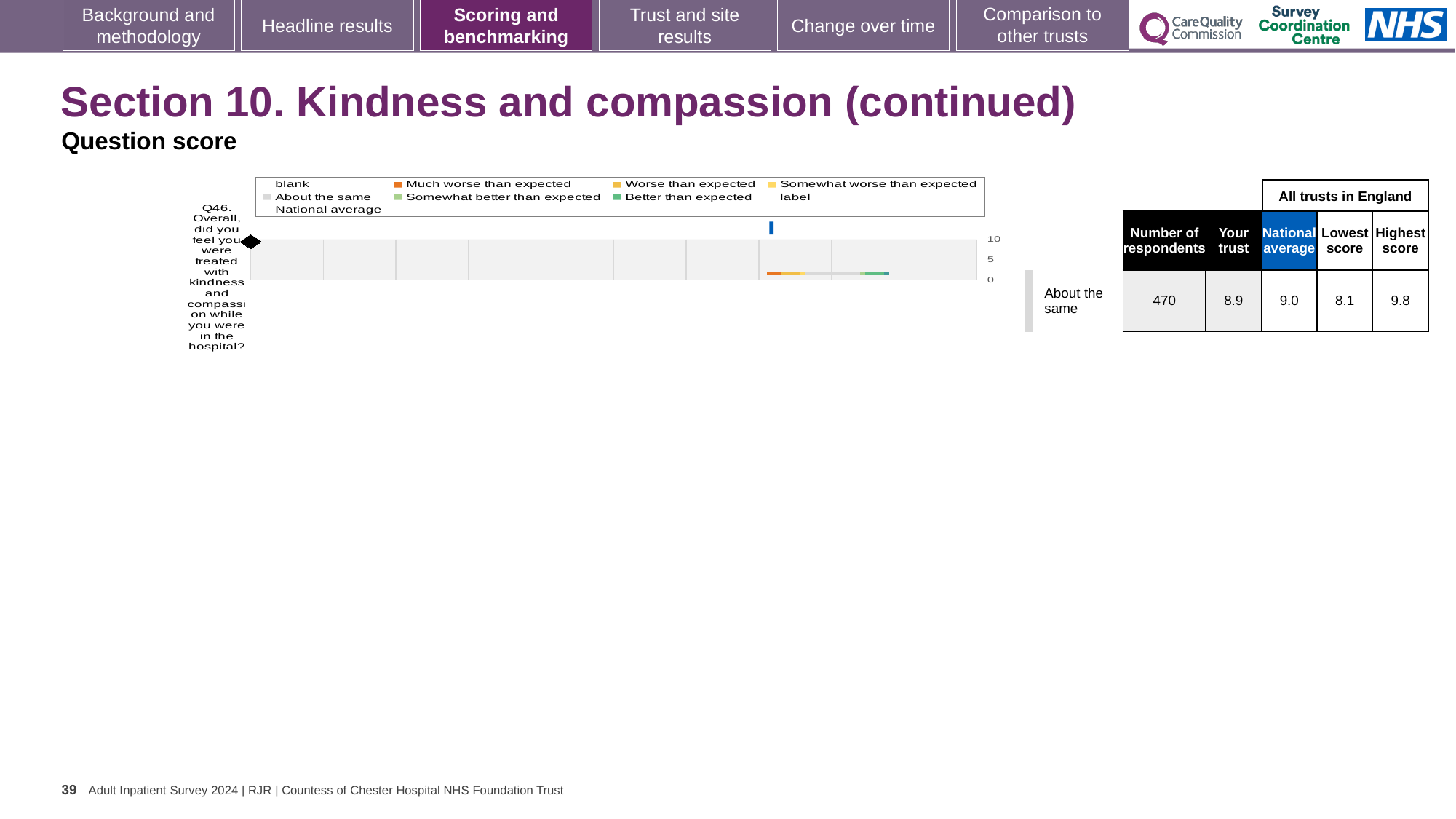
Which benchmark category is the trust's Q46 result placed in? About the same What is the national average score for Q46? 9.0 What colour does the legend use for 'Much worse than expected'? Orange What kind of chart is shown on the slide? Bar chart How many entries does the chart's legend list? 9 Which is larger for Q46, the 'Your trust' score or the national average? National average Which question number does the chart on the slide relate to? Q46 What is the highest score among all trusts in England for Q46? 9.8 How many respondents answered Q46? 470 What is the 'Your trust' score for Q46? 8.9 What is the difference between the highest and lowest scores for Q46? 1.7 What is the lowest score among all trusts in England for Q46? 8.1